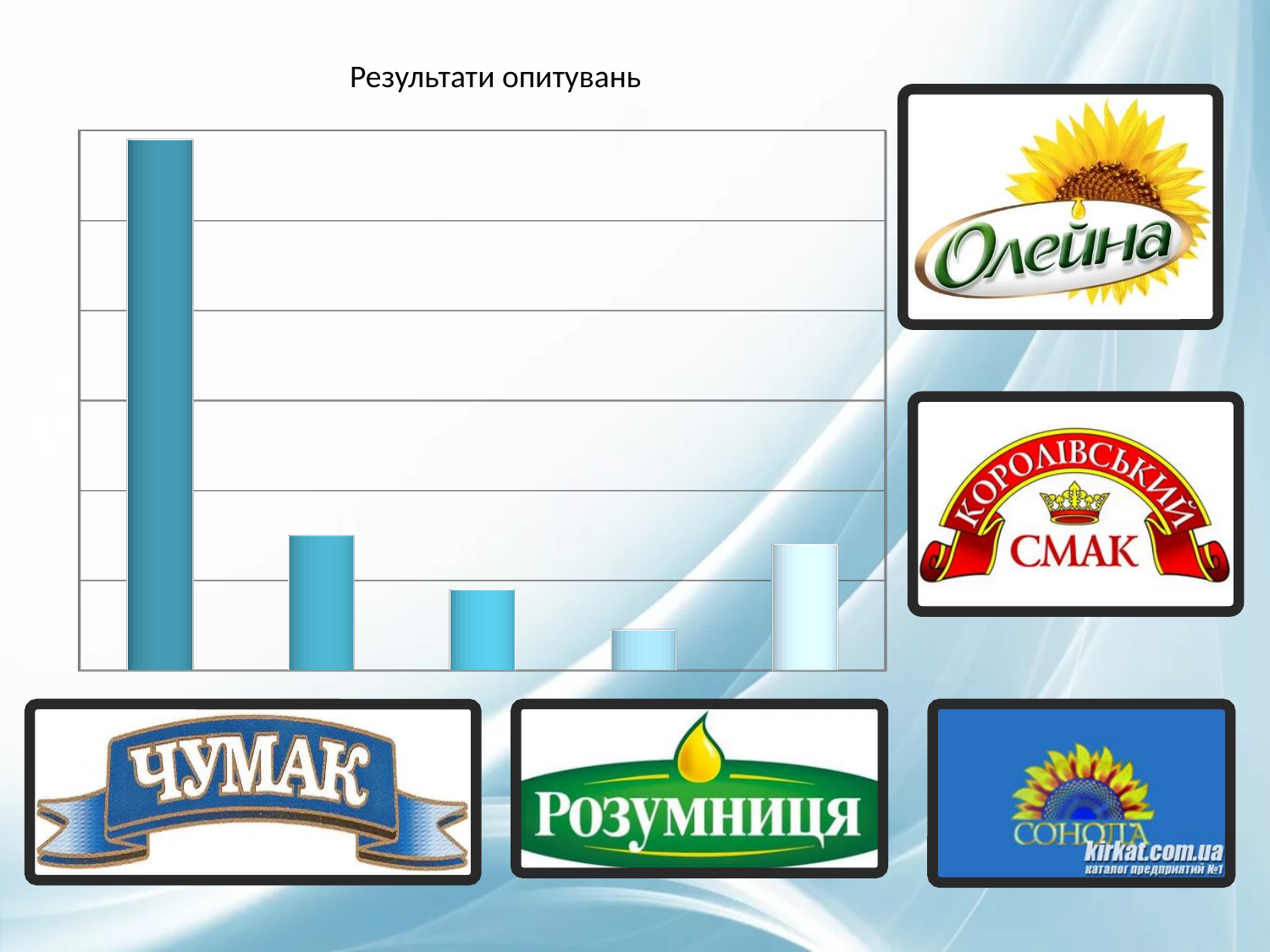
Which bar in the chart is the shortest, counting from the left? the fourth bar Which is taller, the second bar or the third bar from the left? the second bar What kind of chart is shown on the slide? bar chart How many bars are plotted in the chart? 5 Does the chart display a legend? No Which bar in the chart is the tallest, counting from the left? the first (leftmost) bar What is the title of the slide above the chart? Результати опитувань Which is taller, the fourth bar or the fifth bar from the left? the fifth bar Which is taller, the third bar or the fifth bar from the left? the fifth bar